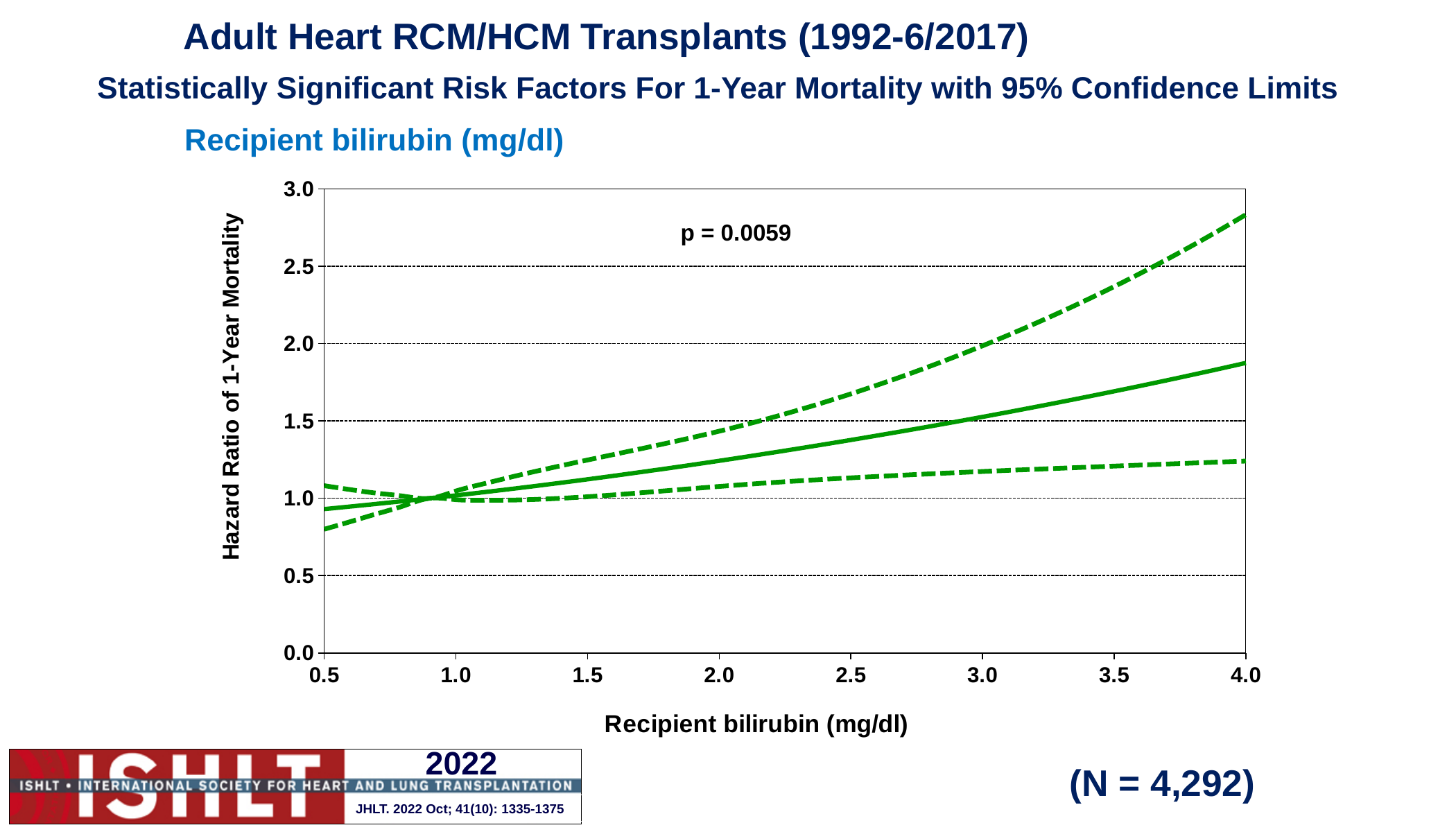
Does the solid hazard ratio line rise or fall as recipient bilirubin increases from 1.0 to 4.0 mg/dl? rise Is the lower dashed confidence limit at a recipient bilirubin of 4.0 mg/dl greater or less than 1.5? less What kind of chart is shown on the slide? line chart What p-value is printed on the chart? p = 0.0059 Is the solid hazard ratio line at a recipient bilirubin of 4.0 mg/dl greater or less than 1.5? greater What is the label of the x axis? Recipient bilirubin (mg/dl) Is the upper dashed confidence limit at a recipient bilirubin of 4.0 mg/dl greater or less than 2.5? greater What is the sample size (N) shown on the slide? 4,292 What is the label of the y axis? Hazard Ratio of 1-Year Mortality How many lines are plotted on the chart? 3